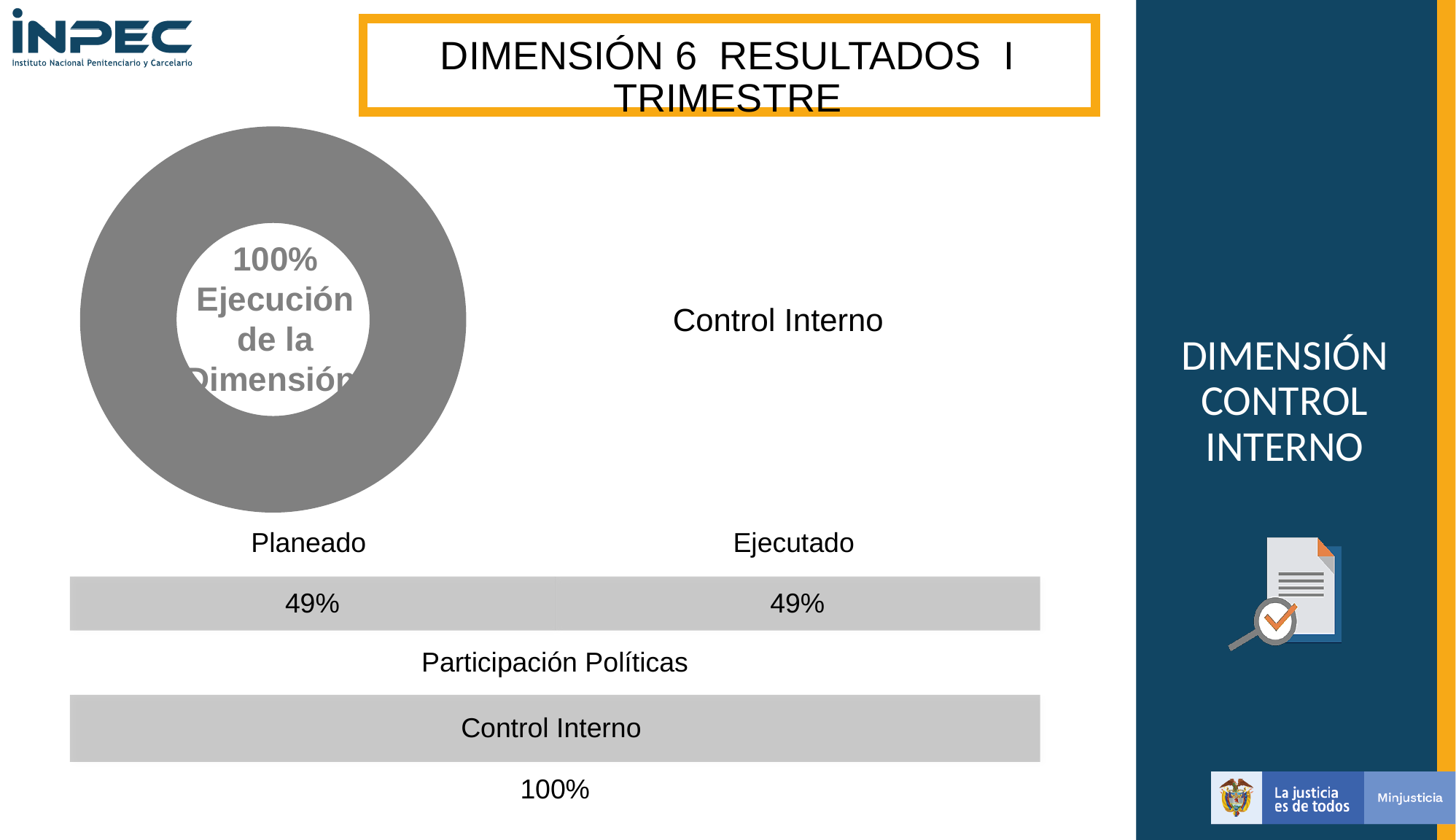
What percentage is shown in the centre of the donut chart? 100% What colour is the slice of the donut chart? Grey What share of the donut chart does the single slice occupy? 100% What text accompanies the 100% value in the centre of the donut chart? Ejecución de la Dimensión In the table below the chart, what is the Ejecutado value for Participación Políticas? 49% What label appears to the right of the donut chart? Control Interno In the table below the chart, what is the Planeado value for Participación Políticas? 49% How many slices does the donut chart have? 1 In the table below the chart, what value is shown for Control Interno? 100% In the table below the chart, is the Planeado value for Participación Políticas greater or less than 50%? less What kind of chart is shown on the left of the slide? Pie chart (donut)